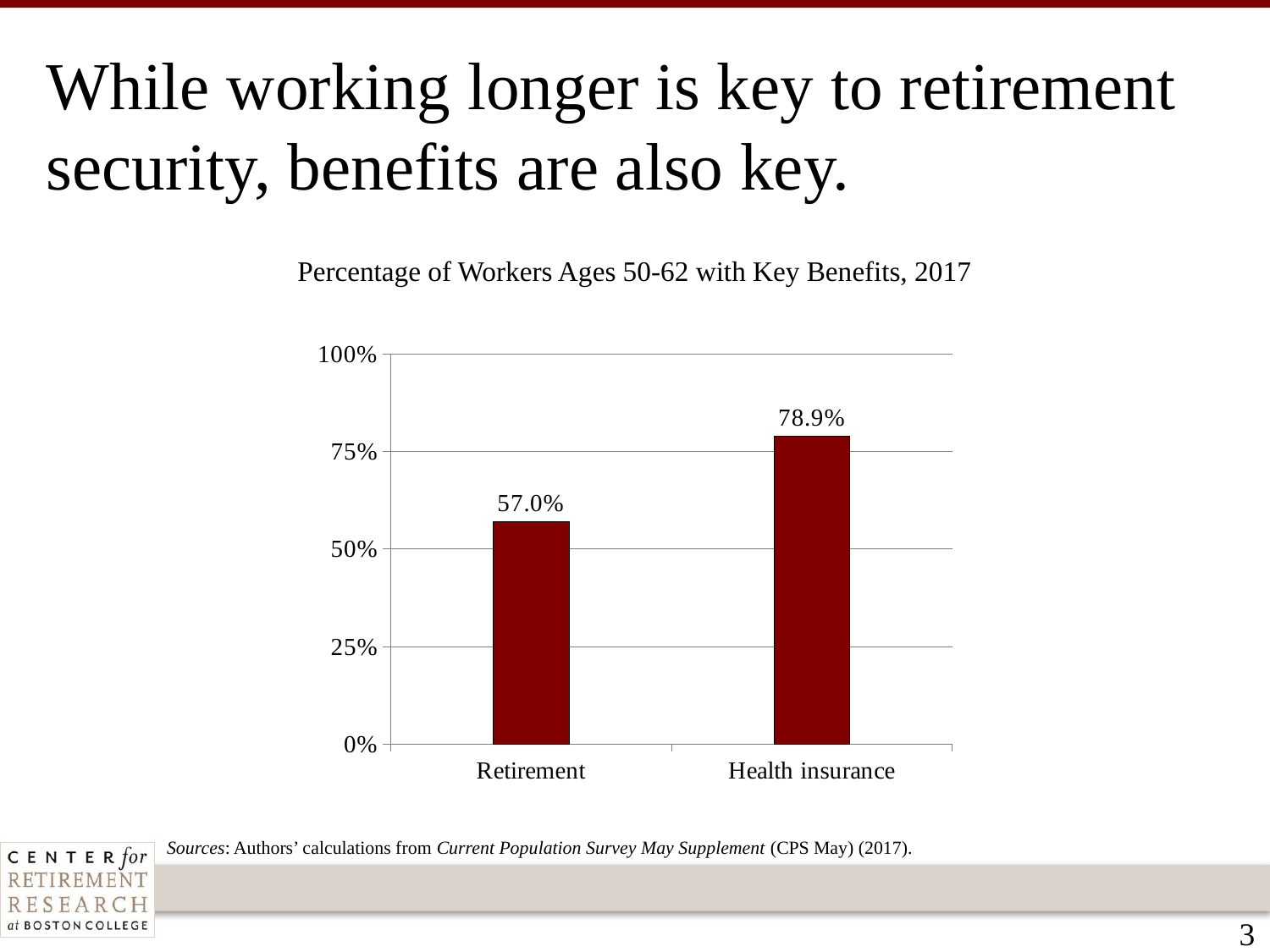
Which benefit has the lower percentage of workers? Retirement What is the title of the chart? Percentage of Workers Ages 50-62 with Key Benefits, 2017 What is the difference in percentage points between health insurance and retirement? 21.9 How many categories are shown on the chart? 2 Is the value for Retirement larger or smaller than the value for Health insurance? Smaller What is the maximum value shown on the y-axis? 100% Which benefit has the higher percentage of workers? Health insurance Is the value for Retirement greater or less than 50%? greater Is the value for Health insurance greater or less than 75%? greater What kind of chart is shown on the slide? Bar chart What percentage of workers ages 50-62 have retirement benefits? 57.0% What percentage of workers ages 50-62 have health insurance? 78.9%